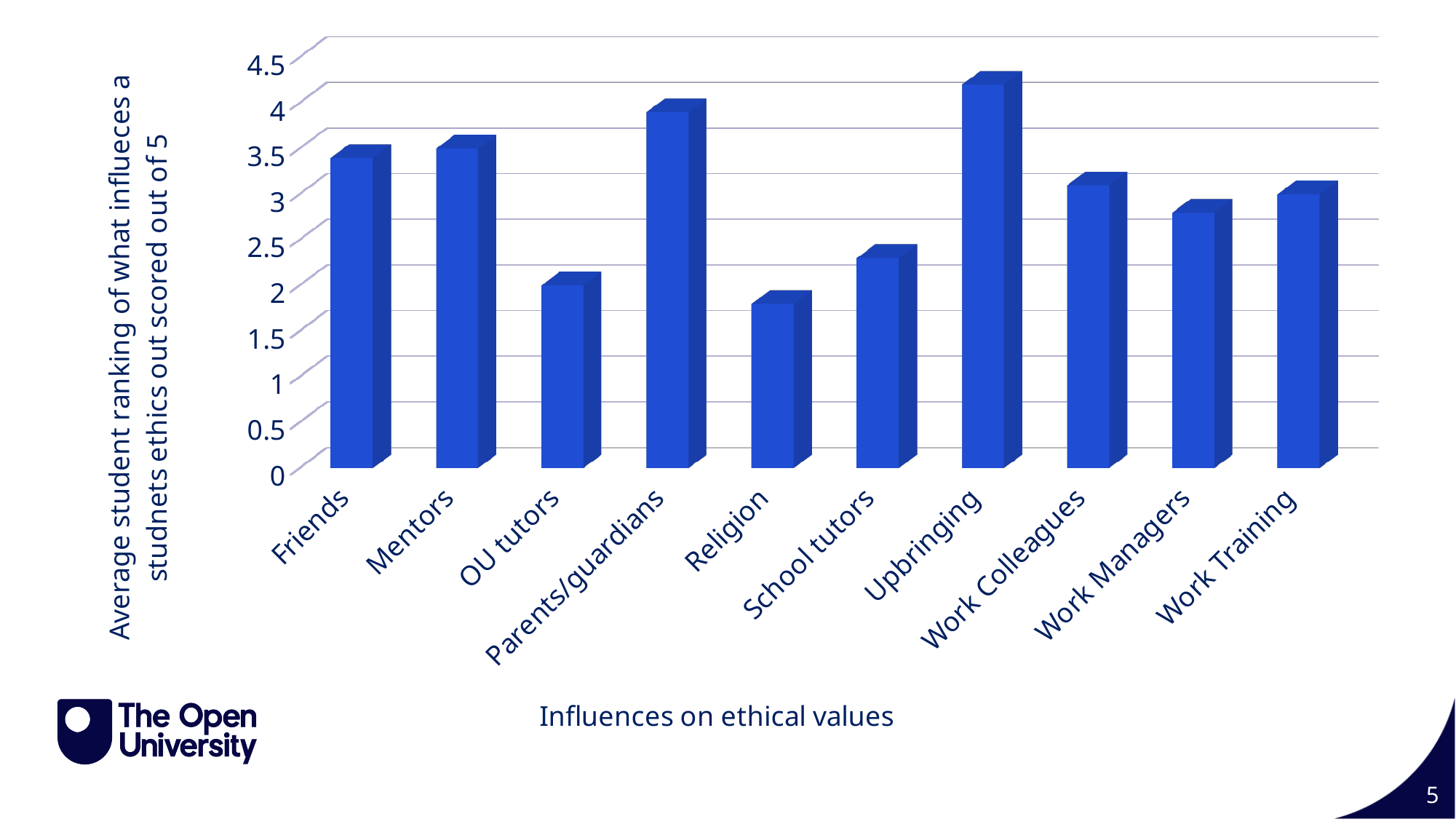
Which has the larger value, Parents/guardians or Friends? Parents/guardians Is the value for School tutors greater or less than 2? greater What is the title of the x axis? Influences on ethical values Which has the larger value, Religion or School tutors? School tutors Is the value for Parents/guardians greater or less than 3.5? greater Which influence has the lowest average student ranking? Religion Is the value for Upbringing greater or less than 4? greater How many categories (influences) are plotted on the x axis? 10 Which influence has the highest average student ranking? Upbringing What kind of chart is shown on the slide? bar chart